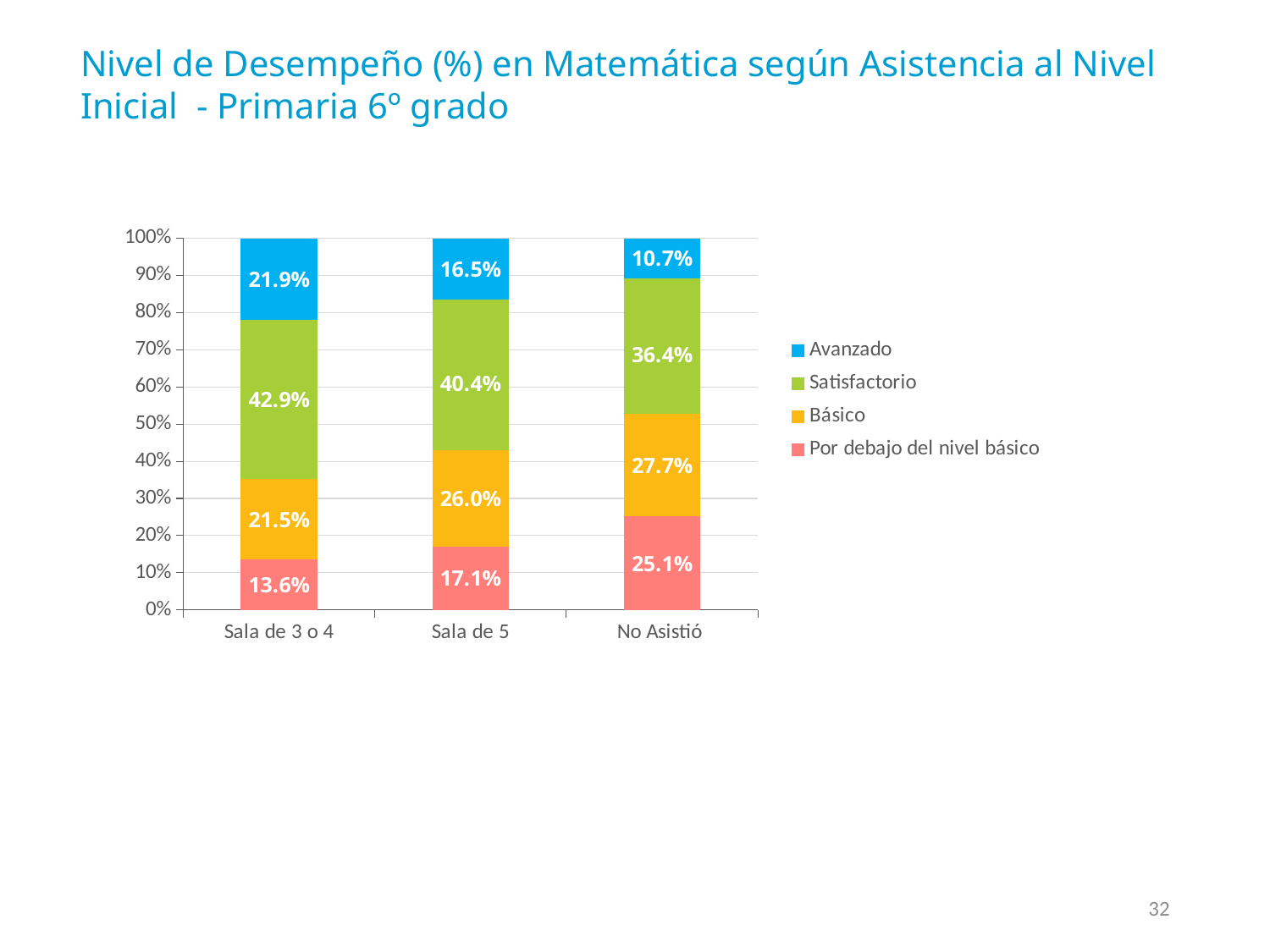
Which legend entry is shown in blue? Avanzado What is the Satisfactorio value for No Asistió? 36.4% What is the Avanzado value for Sala de 3 o 4? 21.9% Which category has the lowest Por debajo del nivel básico value? Sala de 3 o 4 Which is larger, the Básico value for Sala de 5 or for No Asistió? No Asistió What kind of chart is shown on the slide? Stacked bar chart How many series does the legend list? 4 What is the difference between the Satisfactorio values for Sala de 3 o 4 and No Asistió? 6.5% How many categories are shown on the x axis? 3 What is the Básico value for Sala de 5? 26.0% Which category has the highest Avanzado value? Sala de 3 o 4 What is the Por debajo del nivel básico value for No Asistió? 25.1%